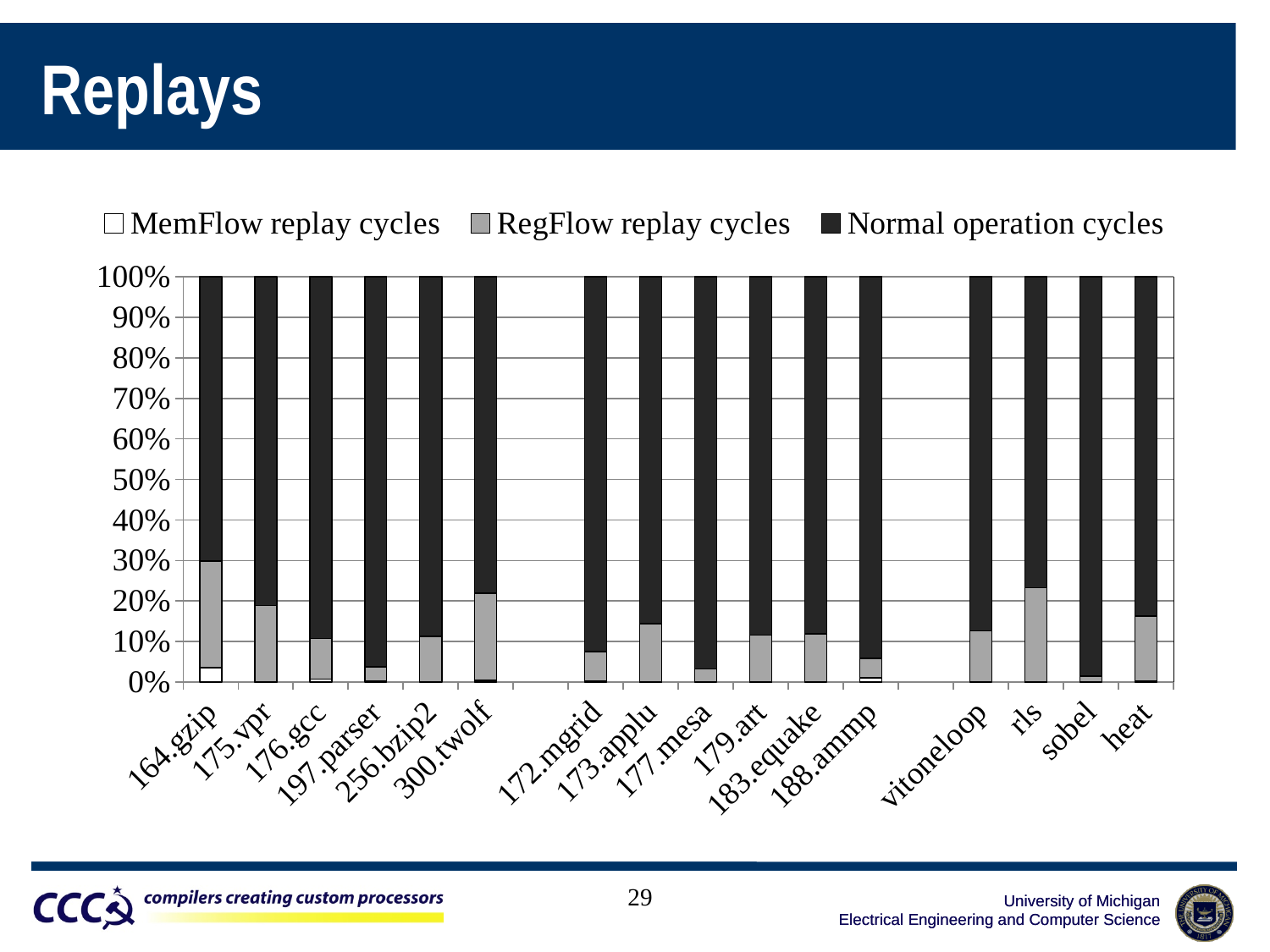
What is the total of the stacked bar for 164.gzip? 100% Which has the larger RegFlow replay cycles share, 175.vpr or 176.gcc? 175.vpr How many benchmark categories are plotted along the x axis? 16 Which category has the smallest share of Normal operation cycles? 164.gzip Is the RegFlow replay cycles value for 177.mesa greater or less than 10%? less Is the RegFlow replay cycles value for rls greater or less than 10%? greater Is the Normal operation cycles value for sobel greater or less than 90%? greater Which series is shown in white in the legend? MemFlow replay cycles What kind of chart is shown on the slide? Stacked bar chart How many series does the legend list? 3 Which has the larger Normal operation cycles share, 300.twolf or 172.mgrid? 172.mgrid